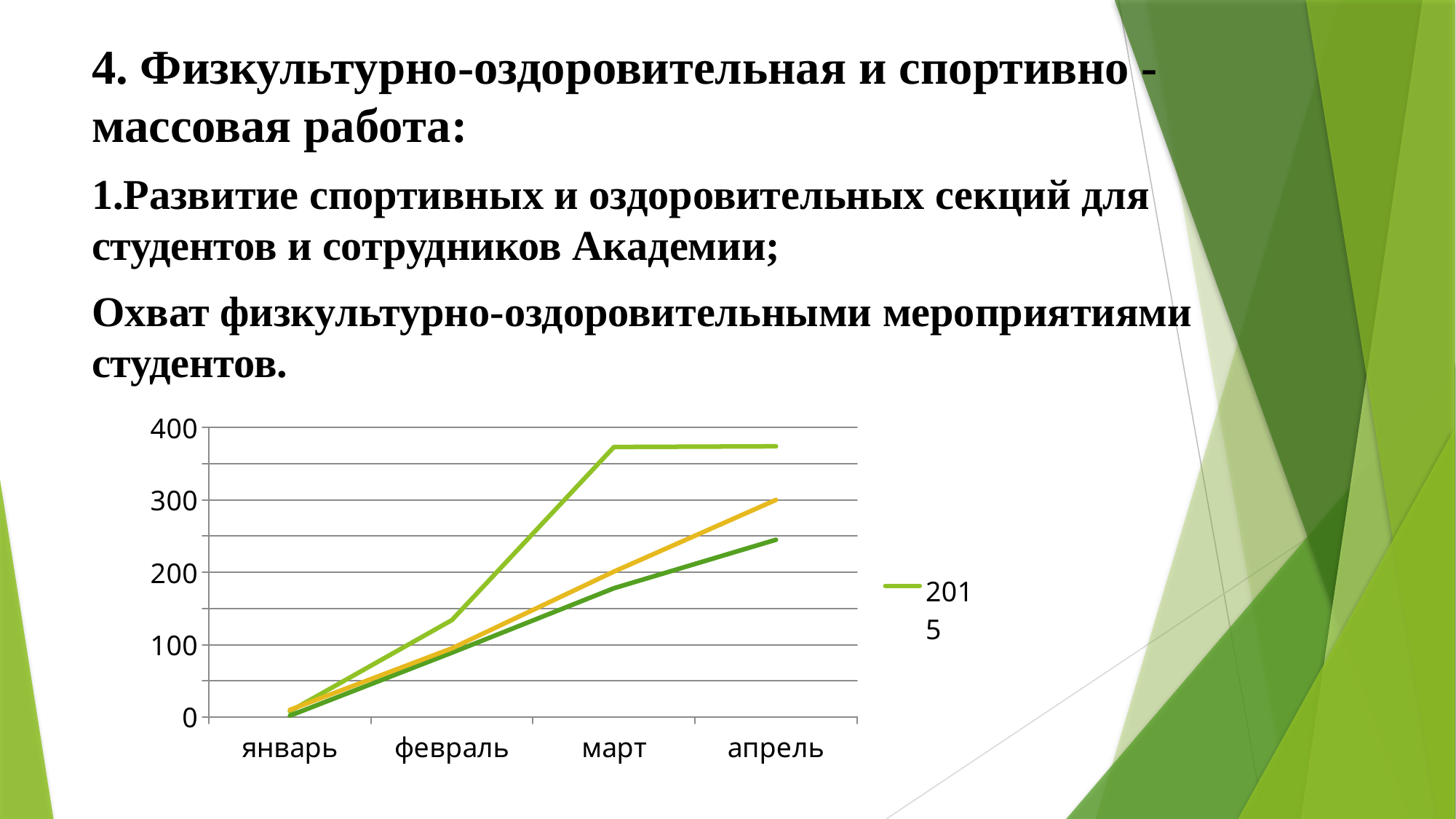
What kind of chart is shown on the slide? line chart Is the value of the 2015 series for февраль greater or less than 200? less Is the value of the 2015 series for апрель greater or less than 300? greater Which month has the lowest value for the 2015 series? январь How many months are shown on the x axis of the chart? 4 What colour is the line for the 2015 series? light green Is the value of the 2015 series for январь greater or less than 100? less Does the 2015 line rise or fall from январь to март? rise How many lines are plotted on the chart? 3 Which series label is readable in the chart legend? 2015 For the 2015 series, which is larger: the value for февраль or the value for март? март